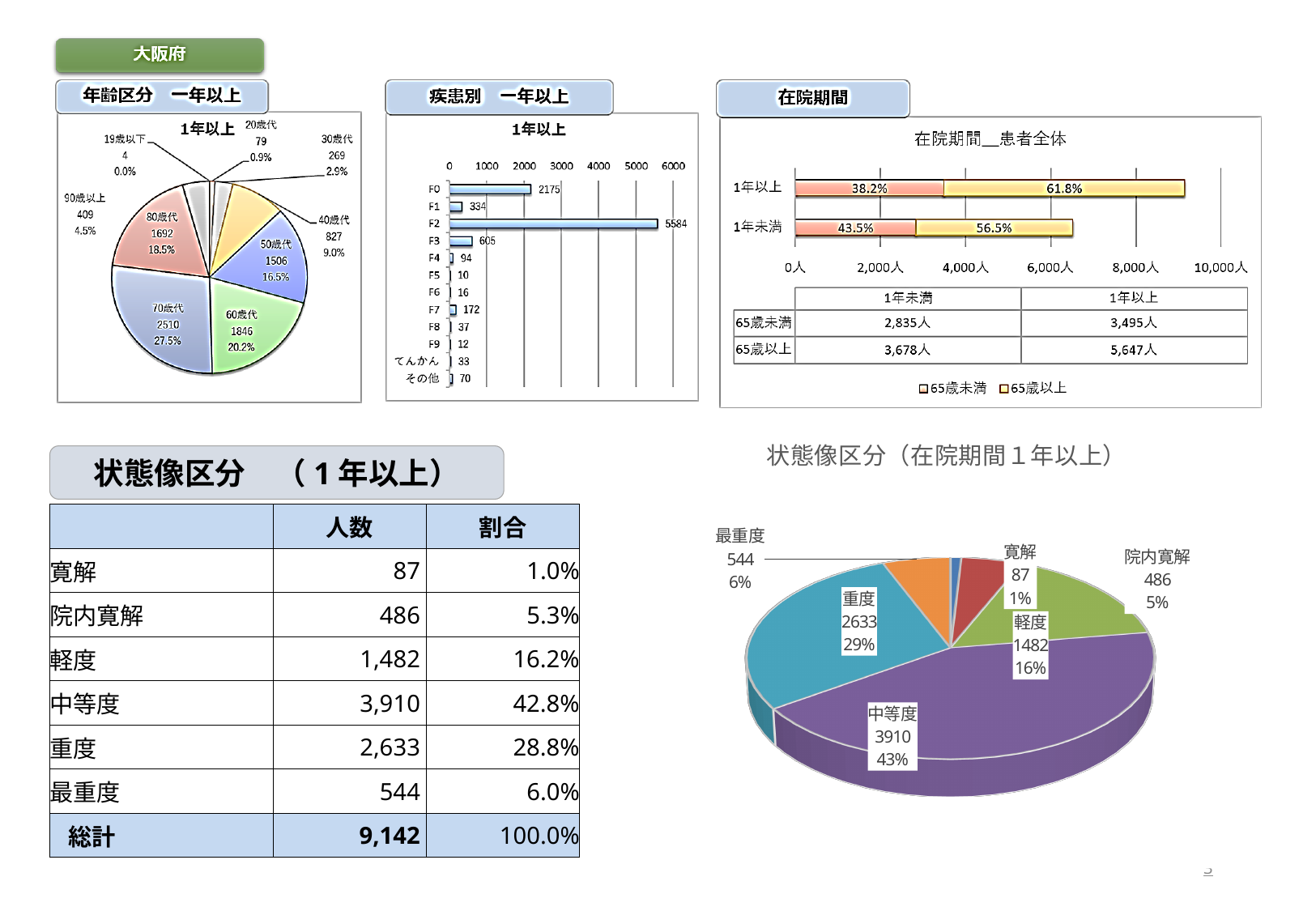
In the 疾患別 一年以上 bar chart, which category has the highest value? F2 What kind of chart is the 疾患別 一年以上 chart? bar chart In the 疾患別 一年以上 bar chart, how many categories are plotted? 12 In the 年齢区分 一年以上 pie chart, what is the number for 70歳代? 2510 In the 年齢区分 一年以上 pie chart, what share does 60歳代 have? 20.2% How many series does the legend of the 在院期間 chart list? 2 In the 疾患別 一年以上 bar chart, what is the difference between F0 and F3? 1570 In the 年齢区分 一年以上 pie chart, which age group has the largest slice? 70歳代 In the 疾患別 一年以上 bar chart, which category has the lowest value? F5 In the 在院期間 chart, what is the 65歳以上 share for 1年以上? 61.8% In the 疾患別 一年以上 bar chart, what is the value for F2? 5584 In the 状態像区分（在院期間１年以上） pie chart, which category is larger, 重度 or 軽度? 重度